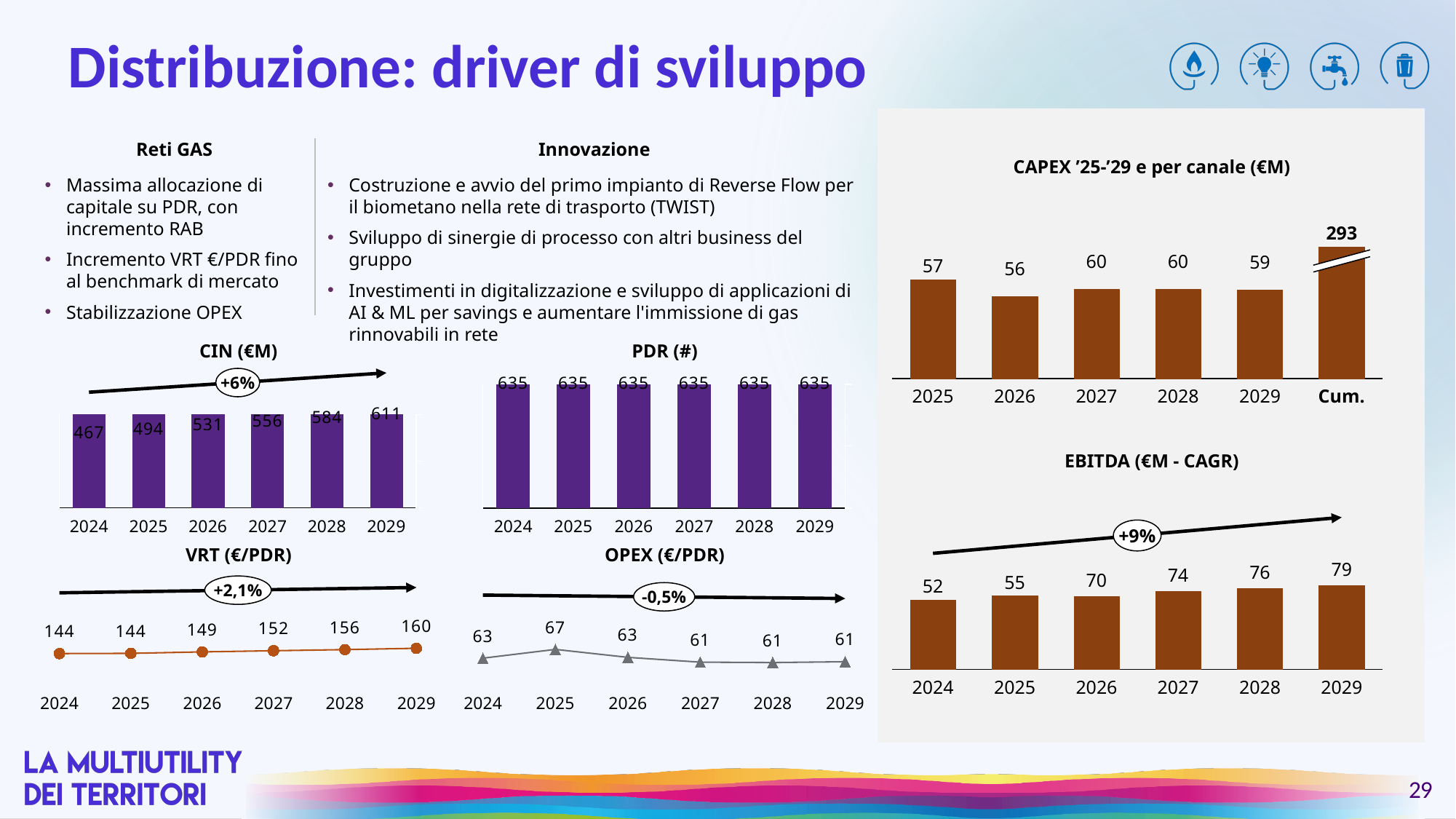
In the OPEX (€/PDR) chart, what is the difference between the 2025 and 2029 values? 6 In the VRT (€/PDR) chart, what growth rate is shown on the arrow? +2,1% In the OPEX (€/PDR) chart, which year has the highest value? 2025 In the PDR (#) chart, what is the value for 2027? 635 In the EBITDA (€M - CAGR) chart, what is the value for 2026? 70 What kind of chart is the EBITDA (€M - CAGR) chart? bar chart In the EBITDA (€M - CAGR) chart, do the values rise or fall from 2024 to 2029? rise In the CIN (€M) chart, what is the difference between the 2029 and 2024 values? 144 In the CIN (€M) chart, what is the value for 2029? 611 In the VRT (€/PDR) chart, what is the value for 2028? 156 In the CAPEX '25-'29 e per canale (€M) chart, which year between 2025 and 2029 has the lowest value? 2026 In the CAPEX '25-'29 e per canale (€M) chart, what is the value for Cum.? 293